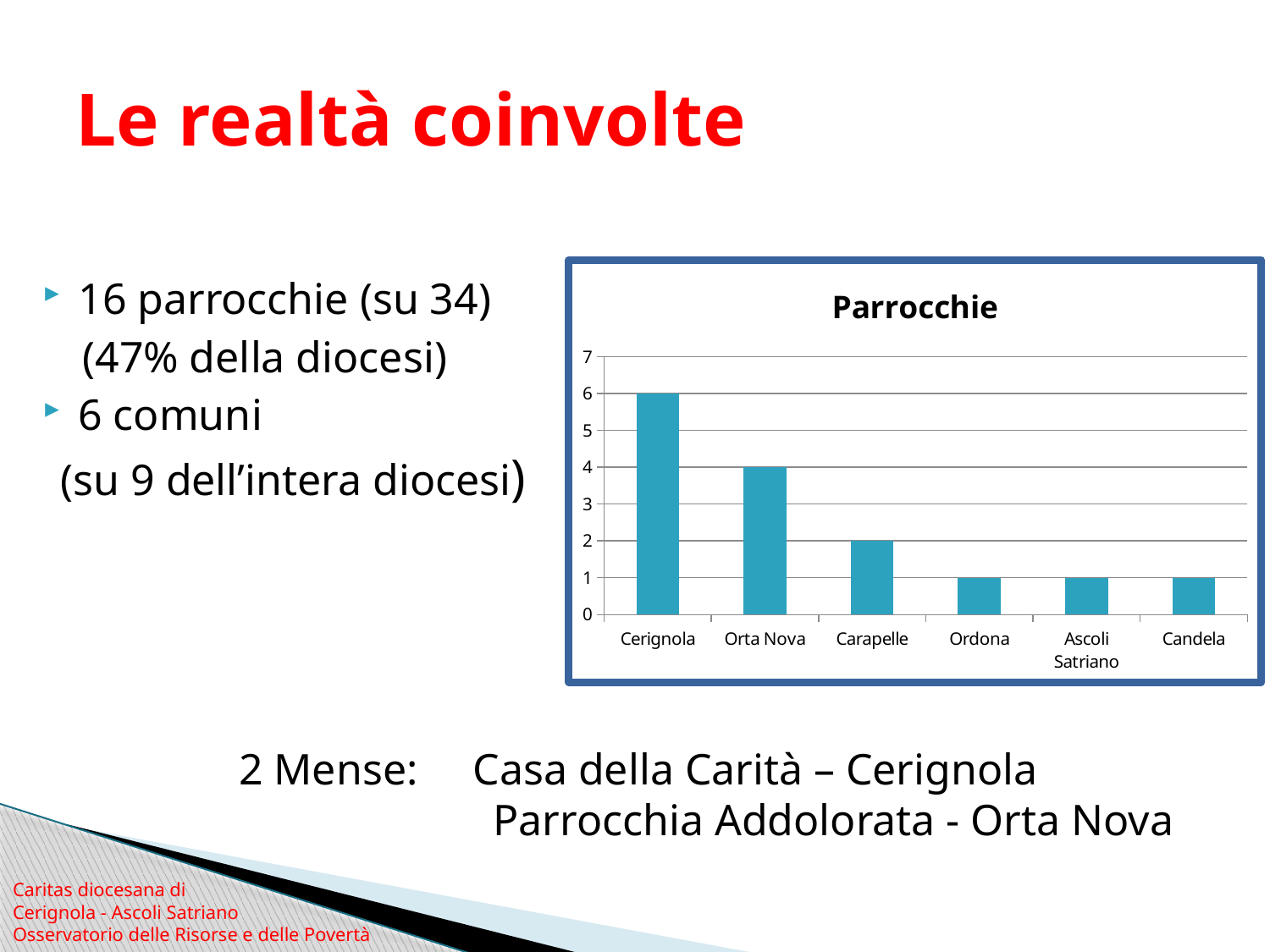
What is the title of the chart? Parrocchie What is the value for Candela in the chart? 1 What is the value for Orta Nova in the chart? 4 Do the values rise or fall moving from left to right along the x axis? fall Which is larger, the value for Orta Nova or the value for Carapelle? Orta Nova What type of chart is shown on the slide? bar chart How many categories are shown on the x axis of the chart? 6 What is the value for Carapelle in the chart? 2 Which category has the highest value in the chart? Cerignola Is the value for Cerignola greater or less than 5? greater What is the difference between the values for Cerignola and Orta Nova? 2 What is the value for Cerignola in the chart? 6